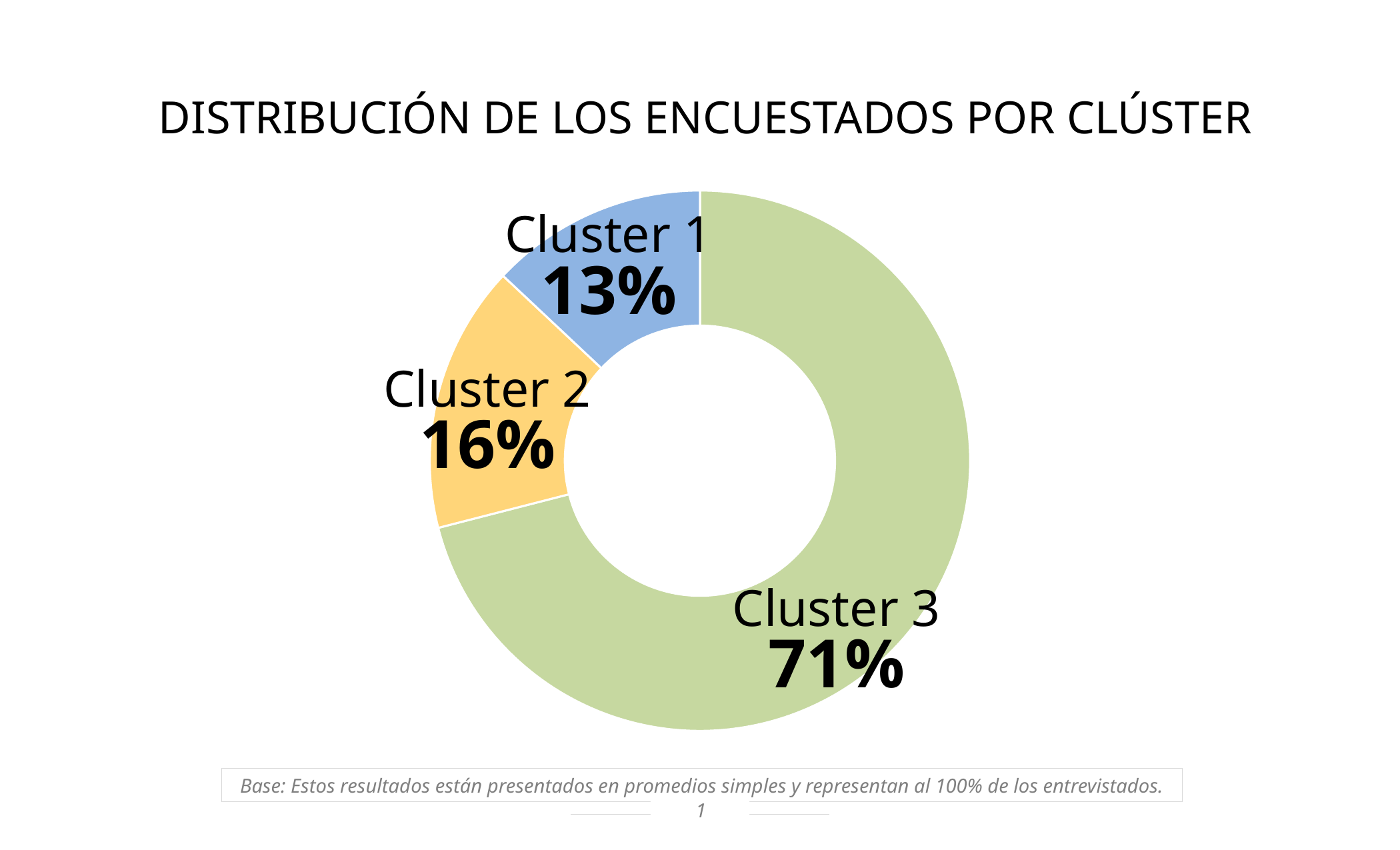
What percentage of respondents are in Cluster 3? 71% What percentage of respondents are in Cluster 1? 13% Which cluster has the largest share of respondents? Cluster 3 What is the difference in percentage points between Cluster 2 and Cluster 1? 3 Which has a larger share, Cluster 1 or Cluster 2? Cluster 2 What is the title of the chart? DISTRIBUCIÓN DE LOS ENCUESTADOS POR CLÚSTER How many clusters are shown in the chart? 3 What colour is the Cluster 3 segment? Green What percentage of respondents are in Cluster 2? 16% What is the difference in percentage points between Cluster 3 and Cluster 2? 55 What type of chart is shown on the slide? Doughnut chart Which cluster has the smallest share of respondents? Cluster 1